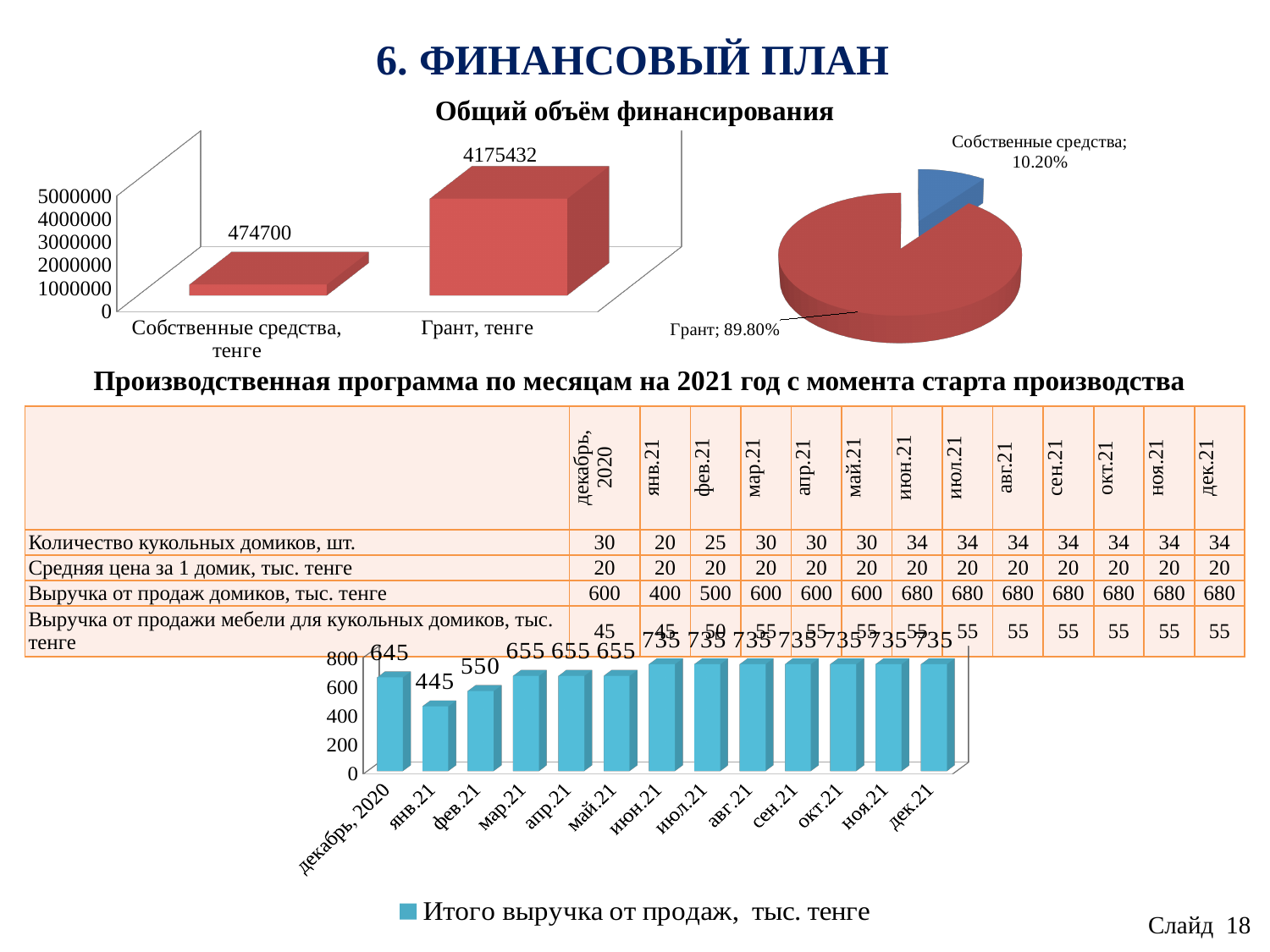
In the bar chart titled "Общий объём финансирования", what is the difference between the values for "Грант, тенге" and "Собственные средства, тенге"? 3700732 In the bar chart titled "Общий объём финансирования", which category has the higher value? Грант, тенге In the bottom bar chart "Итого выручка от продаж, тыс. тенге", which month has the lowest value? янв.21 In the bottom bar chart "Итого выручка от продаж, тыс. тенге", how many months are plotted? 13 In the bar chart titled "Общий объём финансирования", what is the value for "Грант, тенге"? 4175432 In the pie chart at the top right, how many slices are there? 2 In the bar chart titled "Общий объём финансирования", what is the value for "Собственные средства, тенге"? 474700 In the bottom bar chart "Итого выручка от продаж, тыс. тенге", what is the difference between the values for фев.21 and янв.21? 105 In the pie chart at the top right, what share does "Собственные средства" have? 10.20% In the bottom bar chart "Итого выручка от продаж, тыс. тенге", what is the value for дек.21? 735 In the bottom bar chart "Итого выручка от продаж, тыс. тенге", what is the value for янв.21? 445 In the pie chart at the top right, what share does "Грант" have? 89.80%